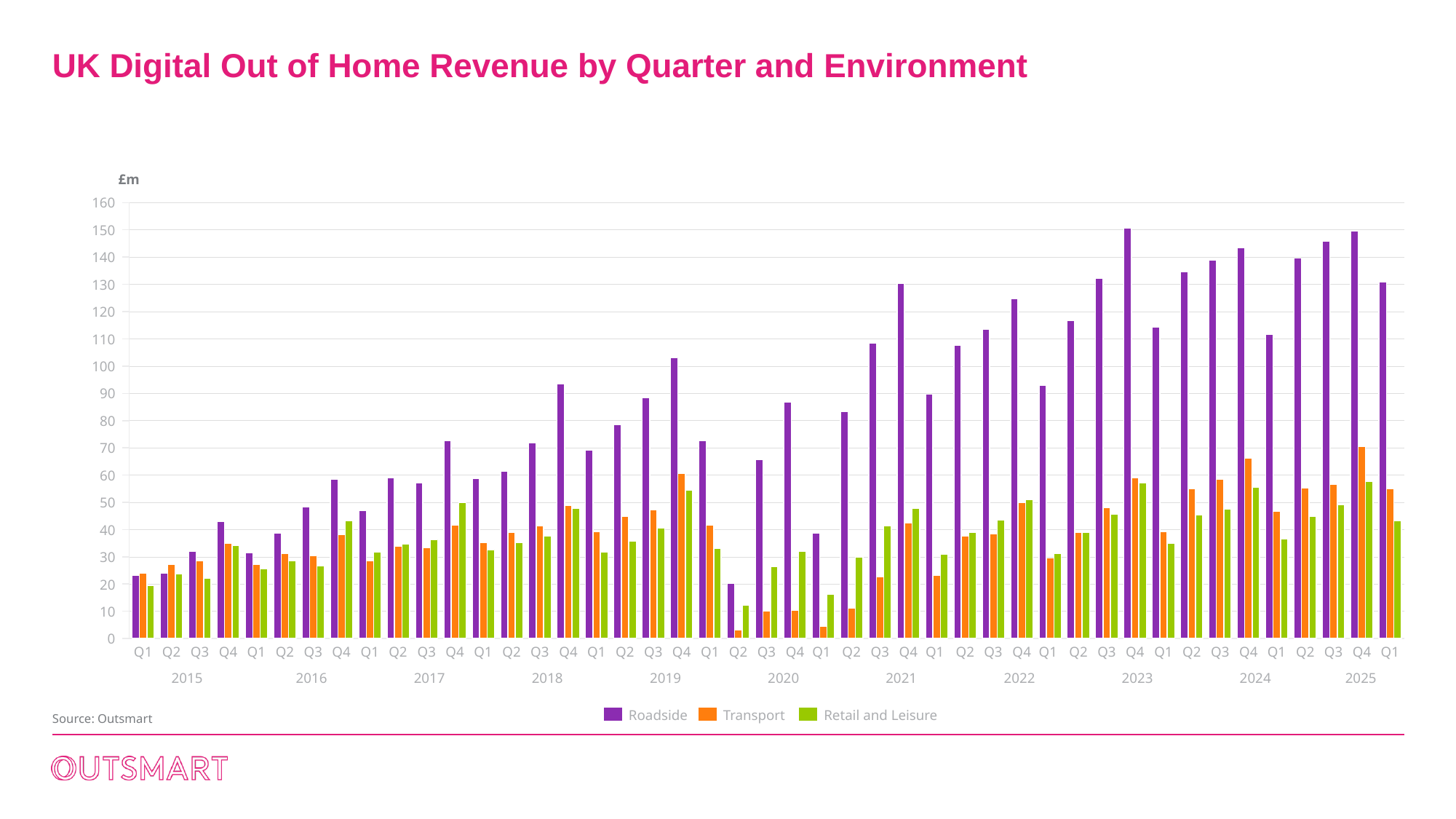
What unit is shown on the y axis? £m How many quarters are plotted along the x axis? 45 Is the Roadside value for Q4 2023 greater or less than 140? greater What kind of chart is shown on the slide? Bar chart Is the Roadside value for Q2 2020 greater or less than 30? less In which quarter is the Transport value highest? Q4 2025 Is the Transport value for Q4 2024 greater or less than 60? greater How many series does the legend list? 3 In which quarter is the Roadside value lowest? Q2 2020 In which quarter is the Retail and Leisure value lowest? Q2 2020 In Q1 2025, which is larger: Transport or Retail and Leisure? Transport